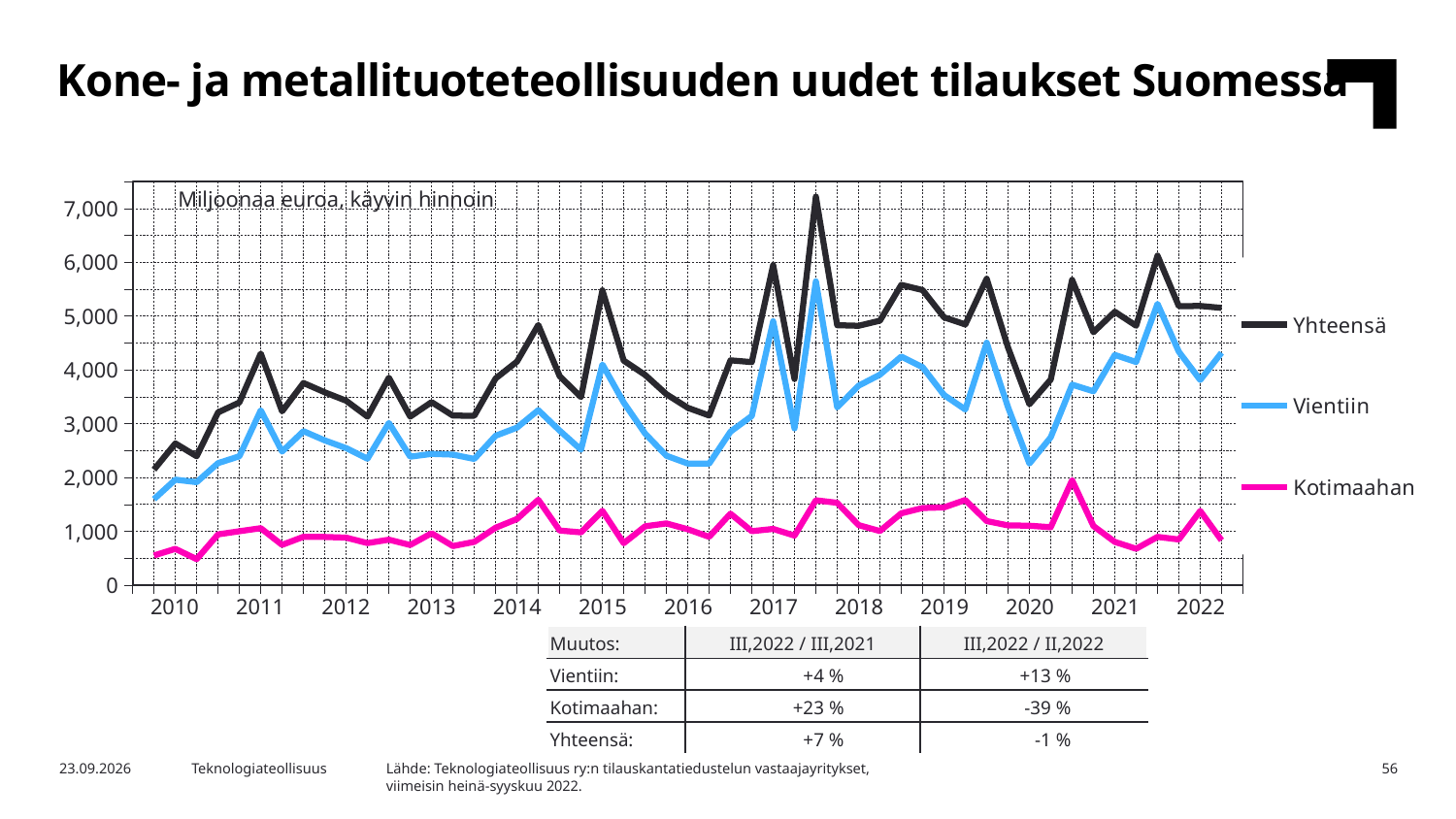
Which series are listed in the chart legend? Yhteensä, Vientiin, Kotimaahan Is the first value of the Vientiin series in 2010 greater or less than 2,000? less Which series is larger in 2022, Vientiin or Kotimaahan? Vientiin How many series does the chart legend list? 3 Is the highest value of the Kotimaahan series greater or less than 3,000? less How many year labels are shown on the x axis? 13 What unit is stated in the chart's subtitle? Miljoonaa euroa, käyvin hinnoin Which series has the highest values throughout the chart? Yhteensä Is the peak value of the Yhteensä series in 2017 greater or less than 6,000? greater What kind of chart is shown on the slide? Line chart Which series has the lowest values throughout the chart? Kotimaahan Does the Yhteensä series overall rise or fall from 2010 to 2022? rise